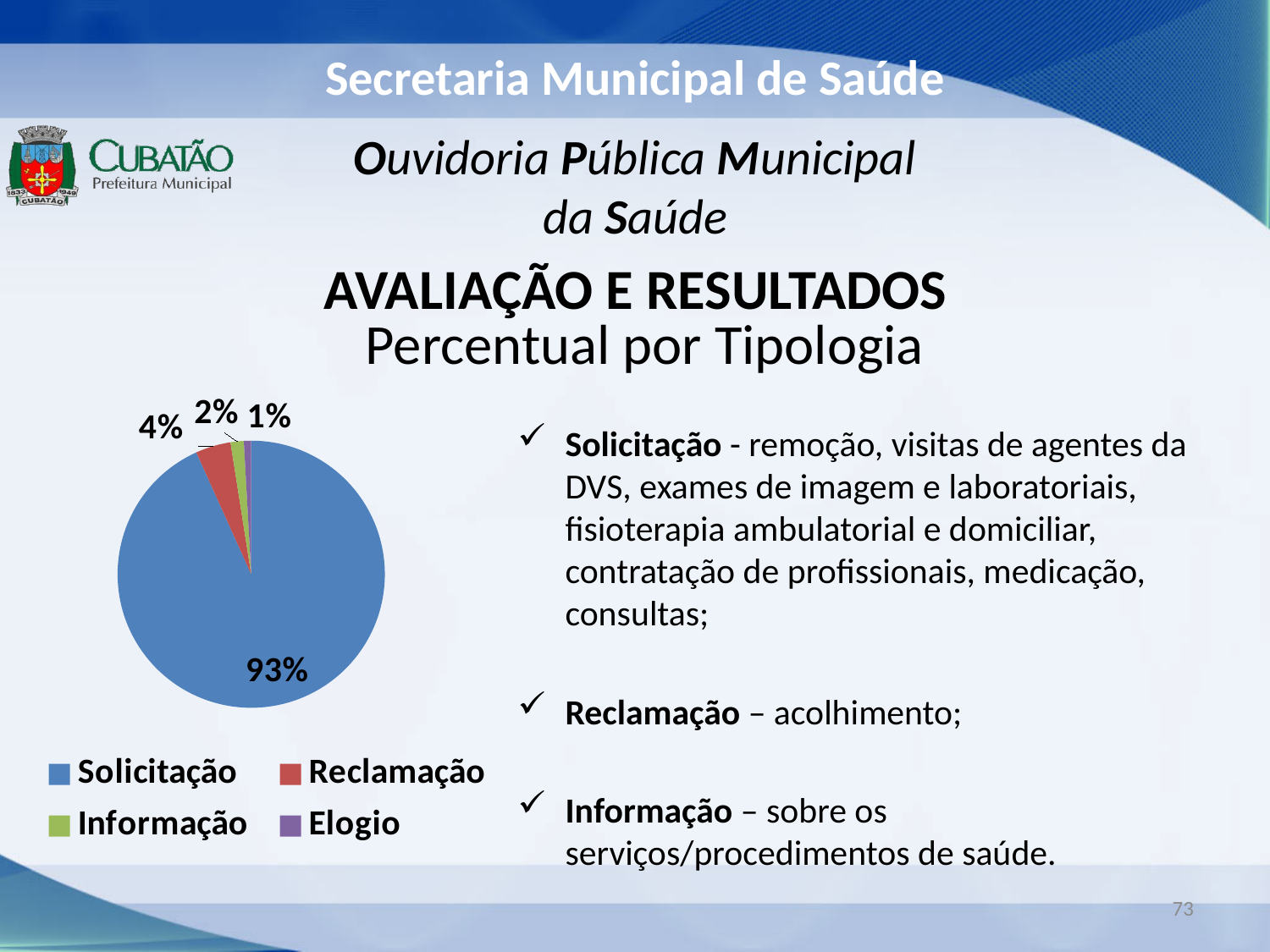
What is the title of the chart? Percentual por Tipologia What colour is the Solicitação slice in the pie chart? blue How many categories does the legend list? 4 Which category has the largest share of the pie? Solicitação Which is larger, the share for Reclamação or the share for Informação? Reclamação What percentage of the pie does Elogio represent? 1% What percentage of the pie does Informação represent? 2% What is the difference in percentage points between Solicitação and Reclamação? 89 What percentage of the pie does Solicitação represent? 93% What kind of chart is shown on the slide? pie chart What percentage of the pie does Reclamação represent? 4% Which category has the smallest share of the pie? Elogio